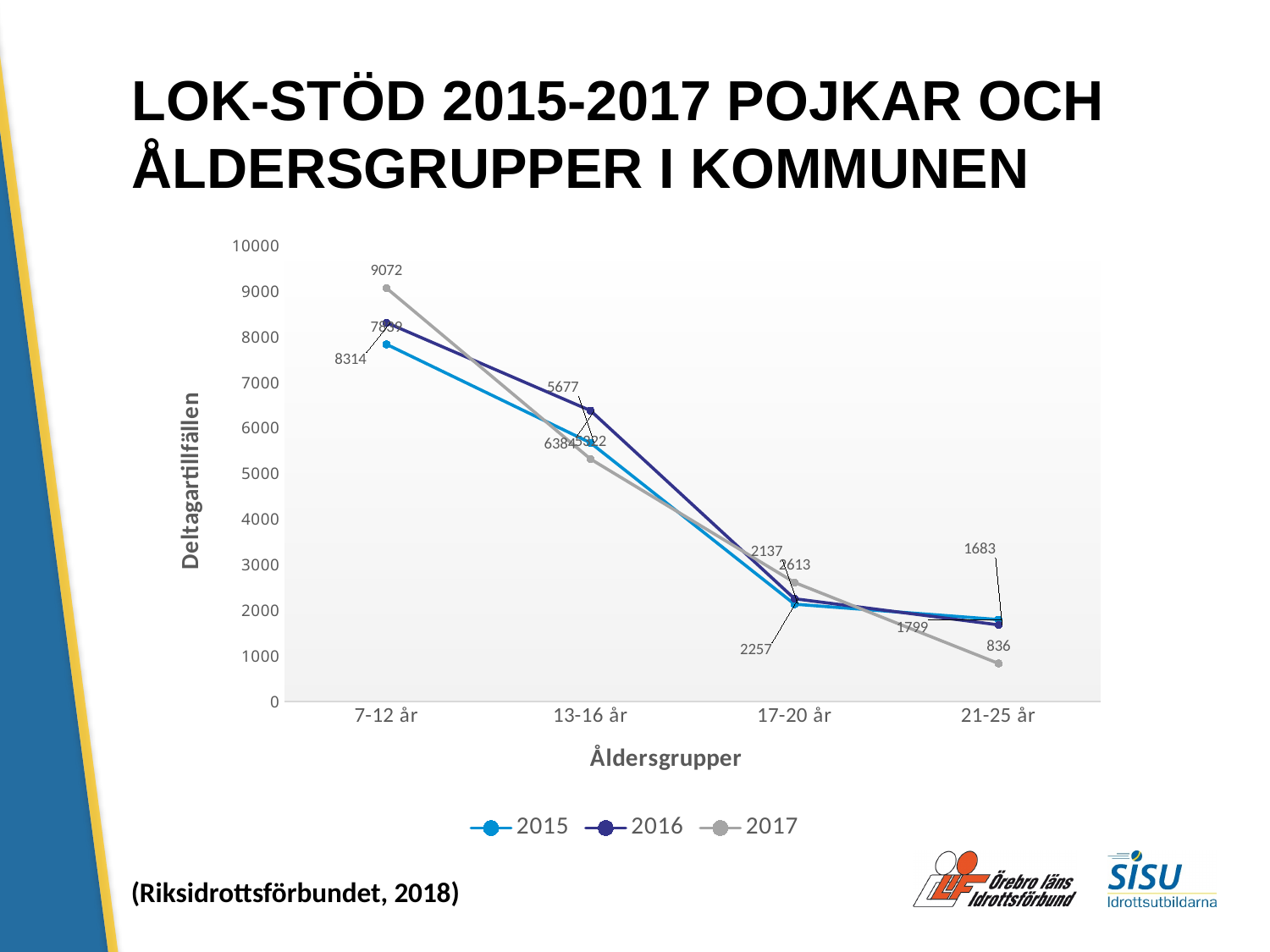
What is the value for 2017 in the 17-20 år age group? 2613 What is the difference between the 2017 value and the 2015 value in the 7-12 år age group? 1233 Which age group has the highest value for the 2017 series? 7-12 år What is the value for 2015 in the 7-12 år age group? 7839 How many series does the legend list? 3 What kind of chart is shown on the slide? line chart What is the value for 2017 in the 21-25 år age group? 836 Which age group has the lowest value for the 2017 series? 21-25 år How many age groups are shown on the x axis? 4 What is the value for 2017 in the 7-12 år age group? 9072 In the 7-12 år age group, which series has the larger value, 2015 or 2017? 2017 Is the value for 2016 in the 13-16 år age group greater or less than 6000? greater